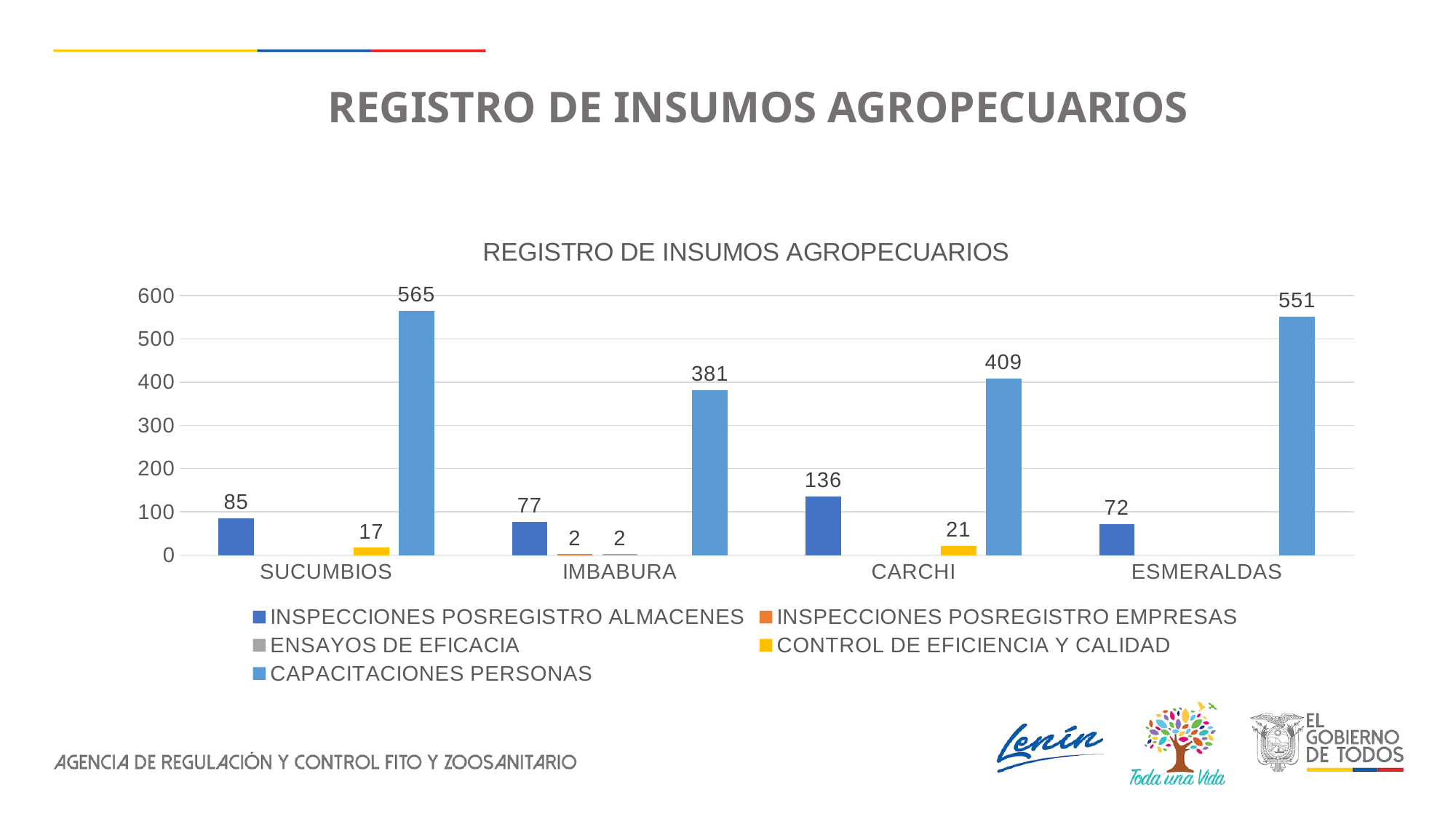
What is the value of INSPECCIONES POSREGISTRO ALMACENES for CARCHI? 136 What kind of chart is shown on the slide? Bar chart What is the value of ENSAYOS DE EFICACIA for IMBABURA? 2 Which province has the lowest value for INSPECCIONES POSREGISTRO ALMACENES? ESMERALDAS What is the value of CONTROL DE EFICIENCIA Y CALIDAD for CARCHI? 21 How many series does the legend list? 5 Is the value of CAPACITACIONES PERSONAS for CARCHI greater or less than 400? greater Which province has the highest value for CAPACITACIONES PERSONAS? SUCUMBIOS How many provinces are shown on the x axis? 4 What is the difference between CAPACITACIONES PERSONAS for SUCUMBIOS and for ESMERALDAS? 14 What is the value of CAPACITACIONES PERSONAS for SUCUMBIOS? 565 Which is larger: INSPECCIONES POSREGISTRO ALMACENES for SUCUMBIOS or for IMBABURA? SUCUMBIOS